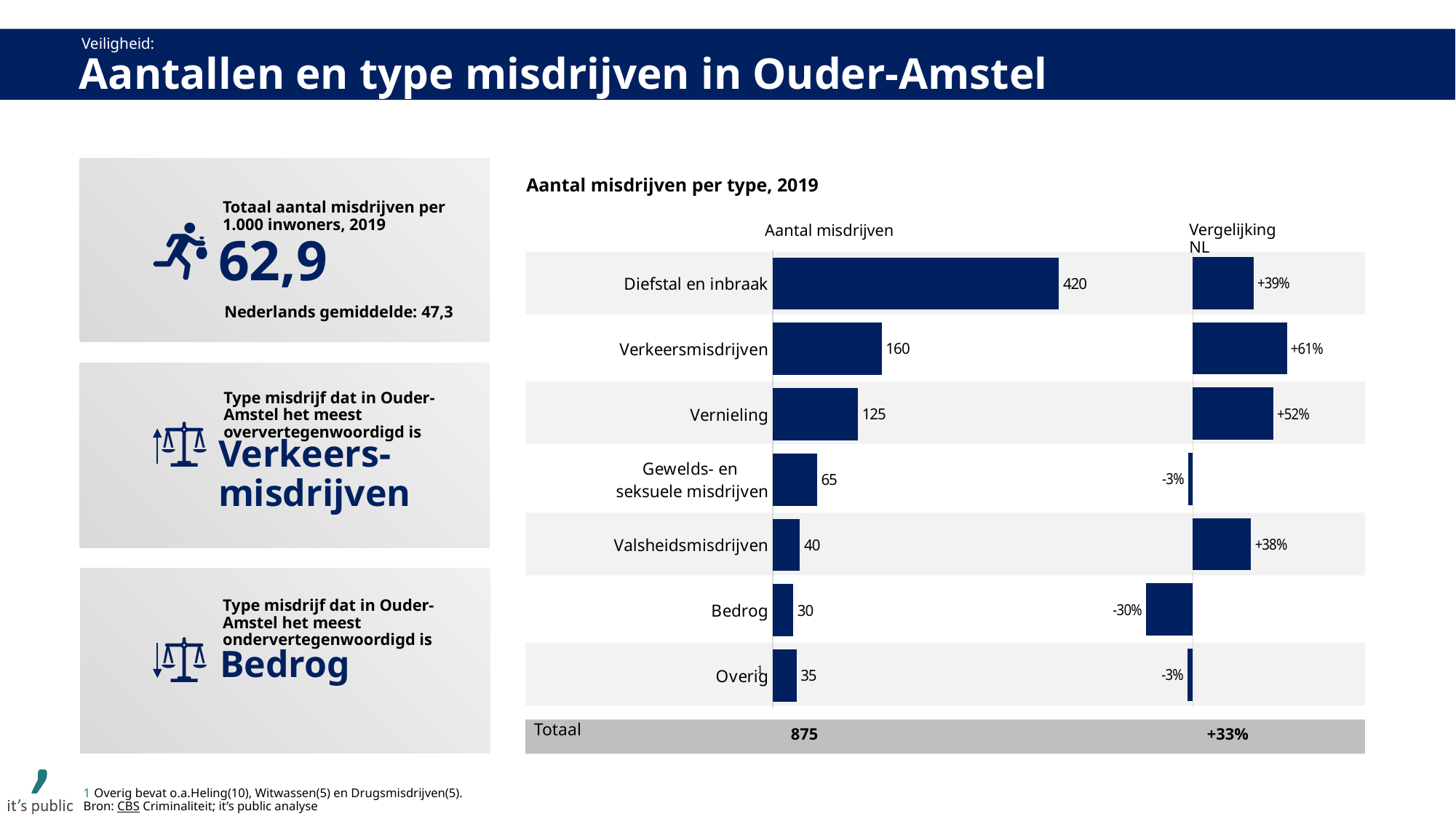
In the chart 'Aantal misdrijven per type, 2019', which type has the highest Aantal misdrijven? Diefstal en inbraak In the chart 'Aantal misdrijven per type, 2019', which type has the lowest Aantal misdrijven? Bedrog In the chart 'Aantal misdrijven per type, 2019', what is the Totaal Aantal misdrijven? 875 In the chart 'Aantal misdrijven per type, 2019', which has a higher Aantal misdrijven: Vernieling or Valsheidsmisdrijven? Vernieling In the chart 'Aantal misdrijven per type, 2019', what is the Vergelijking NL value for Verkeersmisdrijven? +61% In the chart 'Aantal misdrijven per type, 2019', what is the Vergelijking NL value for Bedrog? -30% In the chart 'Aantal misdrijven per type, 2019', what is the difference in Aantal misdrijven between Diefstal en inbraak and Verkeersmisdrijven? 260 How many crime types are shown in the chart 'Aantal misdrijven per type, 2019' (excluding the Totaal row)? 7 In the chart 'Aantal misdrijven per type, 2019', what is the Aantal misdrijven for Gewelds- en seksuele misdrijven? 65 In the chart 'Aantal misdrijven per type, 2019', which type has the highest Vergelijking NL value? Verkeersmisdrijven What kind of chart is 'Aantal misdrijven per type, 2019'? Bar chart In the chart 'Aantal misdrijven per type, 2019', what is the Aantal misdrijven for Diefstal en inbraak? 420